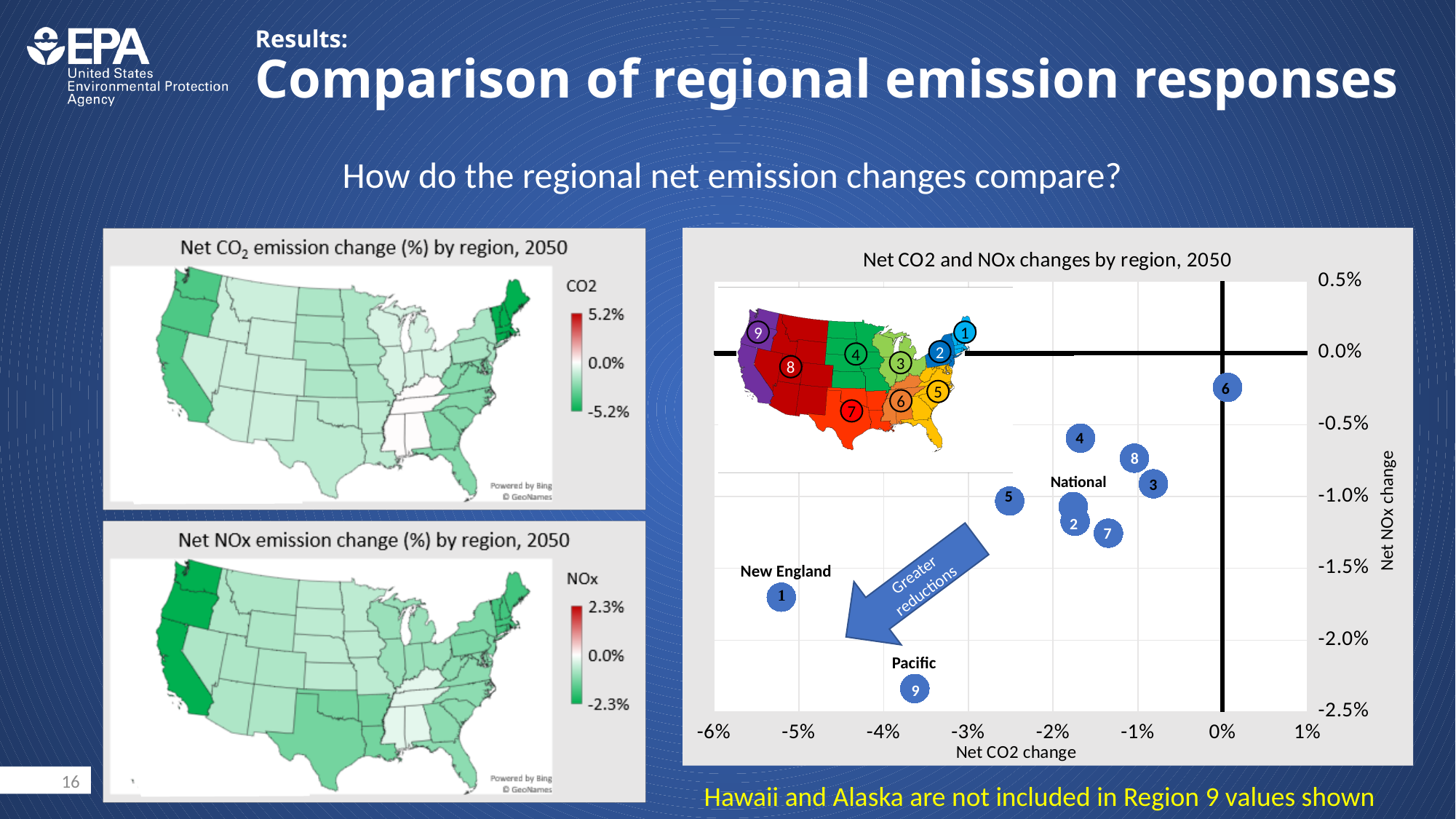
In the chart 'Net CO2 and NOx changes by region, 2050', is the Net NOx change for region 1 (New England) greater or less than -1.5%? less In the chart 'Net CO2 and NOx changes by region, 2050', is the Net NOx change for region 9 (Pacific) greater or less than -2.0%? less In the chart 'Net CO2 and NOx changes by region, 2050', what is the title of the x axis? Net CO2 change In the chart 'Net CO2 and NOx changes by region, 2050', is the Net CO2 change for region 5 greater or less than -2%? less In the chart 'Net CO2 and NOx changes by region, 2050', which labeled point has the highest Net NOx change? 6 What kind of chart is 'Net CO2 and NOx changes by region, 2050'? scatter chart In the chart 'Net CO2 and NOx changes by region, 2050', which labeled point has the lowest Net NOx change? 9 (Pacific) In the chart 'Net CO2 and NOx changes by region, 2050', which has the larger Net CO2 change, region 1 (New England) or region 9 (Pacific)? 9 (Pacific) On the map 'Net CO2 emission change (%) by region, 2050', what is the maximum value shown on the CO2 colour scale? 5.2% In the chart 'Net CO2 and NOx changes by region, 2050', which labeled point has the lowest Net CO2 change? 1 (New England)